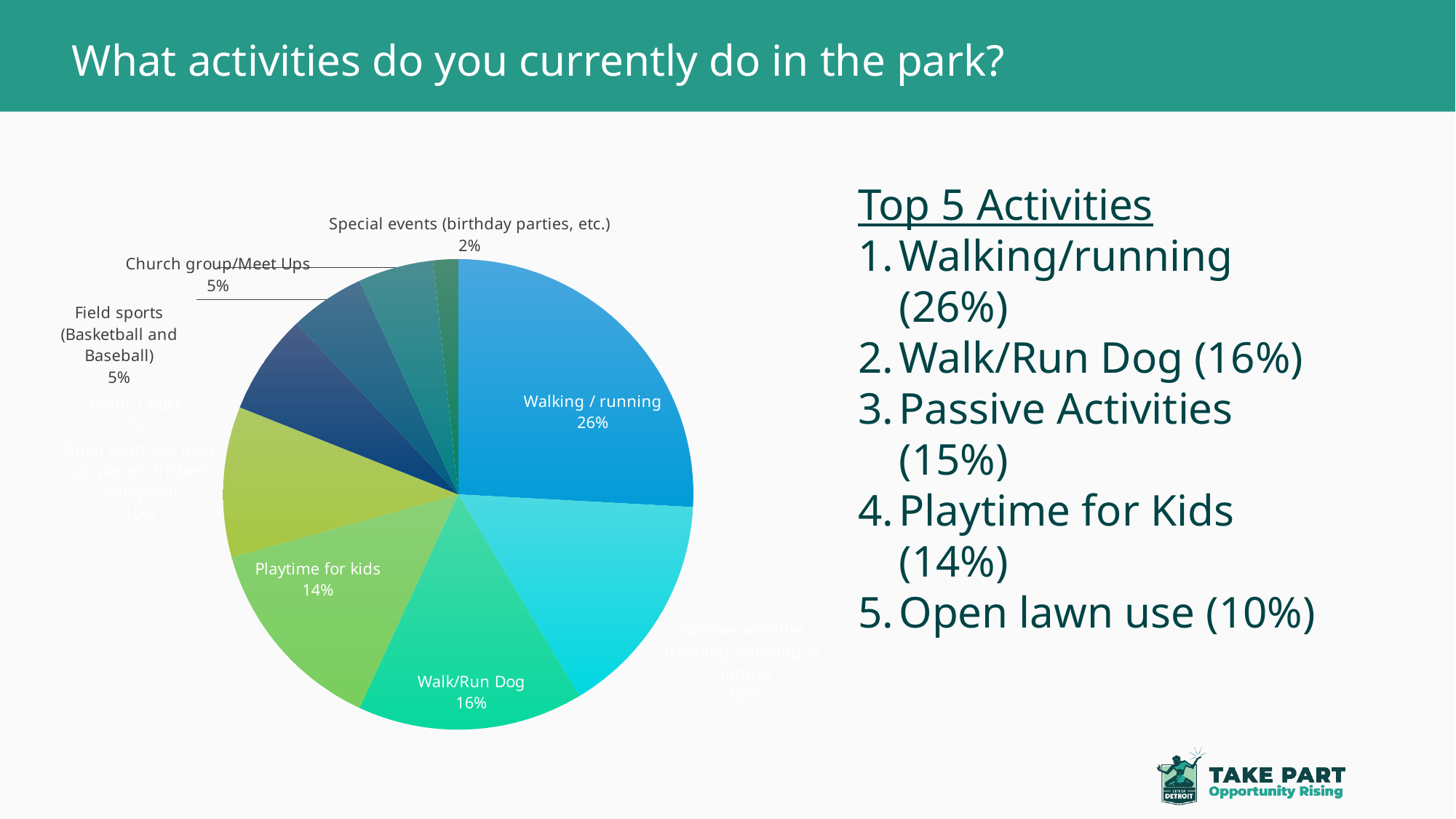
How many slices does the pie chart have? 9 What kind of chart is shown on the slide? Pie chart What percentage of the pie is labelled for Walking / running? 26% Which activity has the smallest slice of the pie? Special events (birthday parties, etc.) Which activity has the largest slice of the pie? Walking / running What percentage is shown for Walk/Run Dog? 16% What percentage is shown for Church group/Meet Ups? 5% What percentage is shown for Special events (birthday parties, etc.)? 2% How many percentage points larger is Walking / running than Walk/Run Dog? 10 Which is larger, the slice for Walk/Run Dog or the slice for Playtime for kids? Walk/Run Dog What percentage is shown for Field sports (Basketball and Baseball)? 5% What percentage is shown for Playtime for kids? 14%